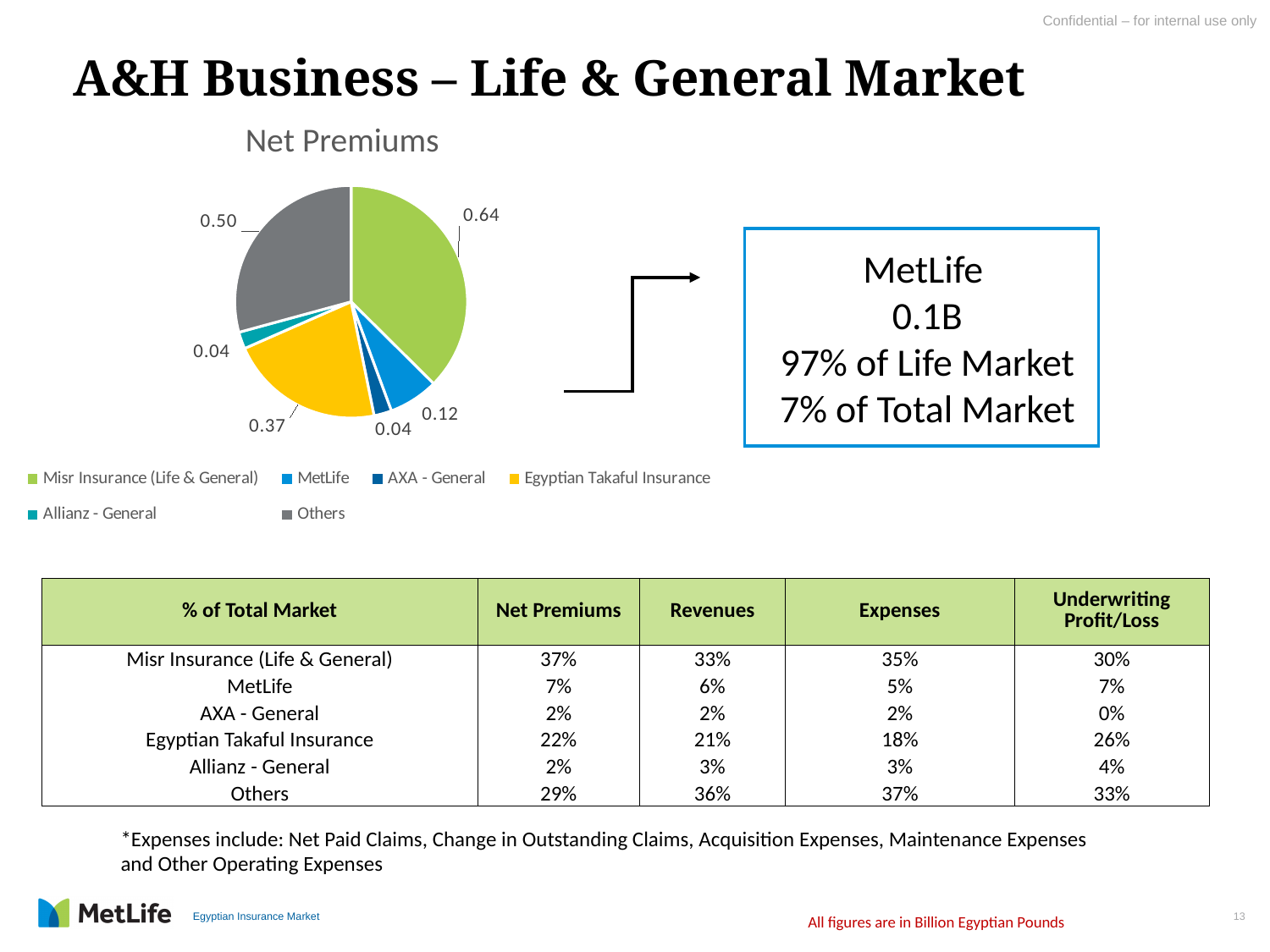
In the Net Premiums pie chart, what is the value for MetLife? 0.12 What is the title of the chart on the slide? Net Premiums How many entries does the legend of the Net Premiums pie chart list? 6 In the Net Premiums pie chart, which is larger: Others or Egyptian Takaful Insurance? Others In the Net Premiums pie chart, what is the value for AXA - General? 0.04 What type of chart is shown under the title "Net Premiums"? Pie chart In the Net Premiums pie chart, what is the value for Misr Insurance (Life & General)? 0.64 In the Net Premiums pie chart, what is the difference between the values for Misr Insurance (Life & General) and Others? 0.14 In the Net Premiums pie chart, what is the value for Others? 0.50 Which category has the largest slice in the Net Premiums pie chart? Misr Insurance (Life & General) How many slices does the Net Premiums pie chart have? 6 In the Net Premiums pie chart, what is the value for Egyptian Takaful Insurance? 0.37